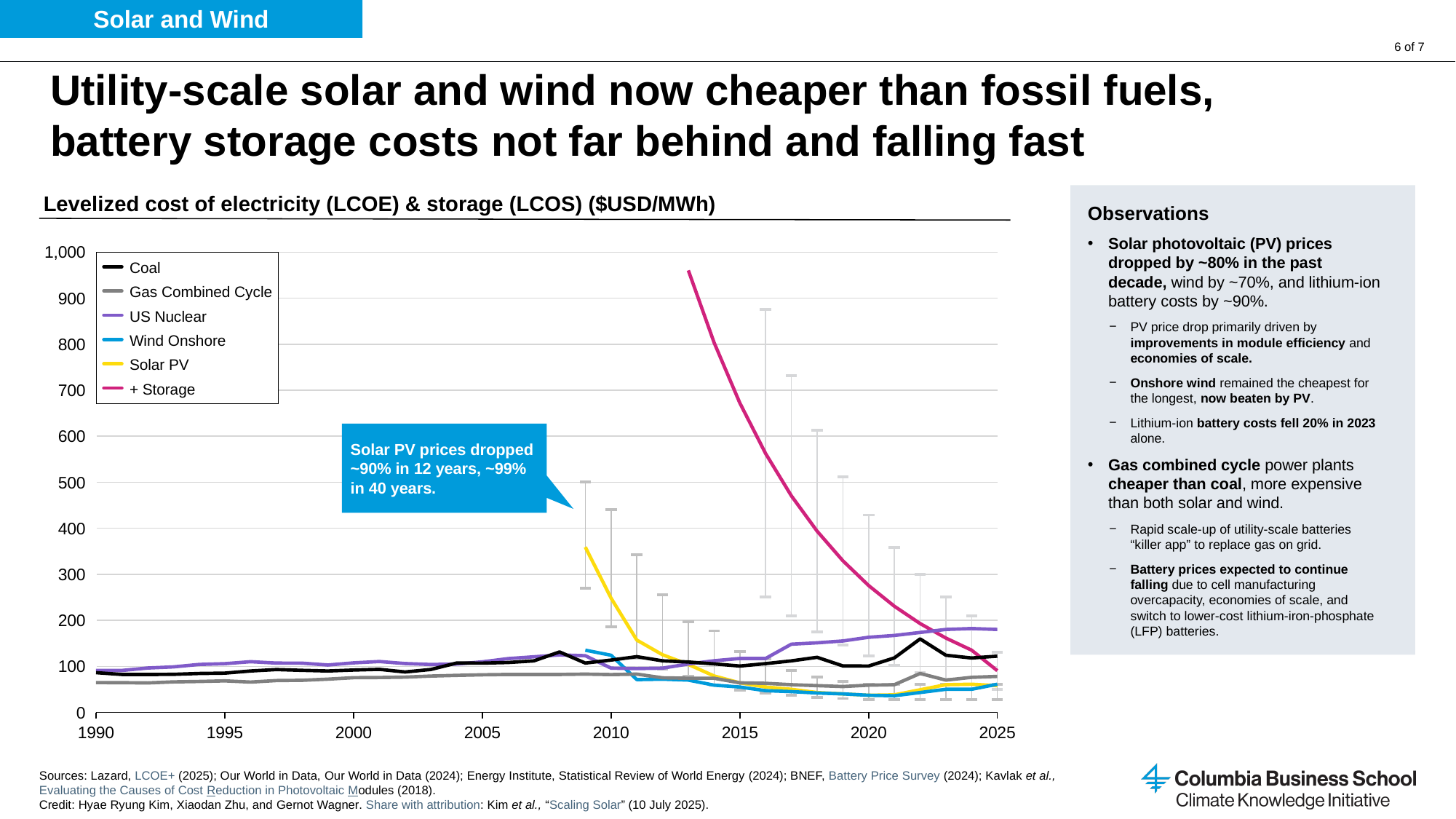
Does the Solar PV line rise or fall from 2009 to 2025? Fall What kind of chart is shown on the slide? Line chart What is the title of the chart? Levelized cost of electricity (LCOE) & storage (LCOS) ($USD/MWh) Which series has the highest value in 2025? US Nuclear In 2025, which is higher: Coal or Gas Combined Cycle? Coal Which colour is used for the Solar PV line in the chart? Yellow Is the value for US Nuclear in 2025 greater or less than 150? greater Is the value for Wind Onshore in 2025 greater or less than 100? less How many series does the chart legend list? 6 Is the value for Coal in 1990 greater or less than 100? less